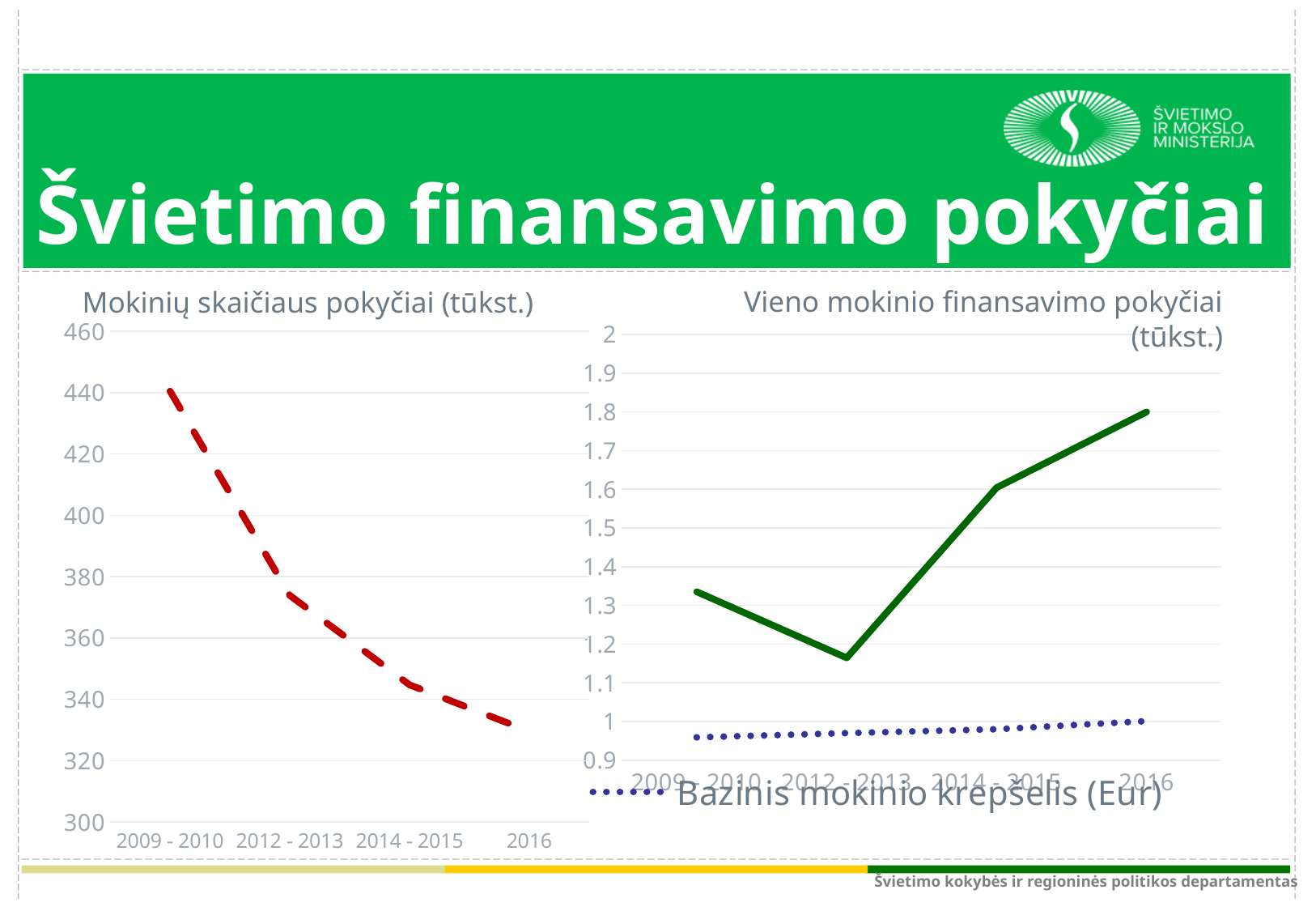
In the right chart 'Vieno mokinio finansavimo pokyčiai (tūkst.)', is the solid green line's value for 2014 - 2015 greater or less than 1.5? greater In the left chart 'Mokinių skaičiaus pokyčiai (tūkst.)', which period has the highest value? 2009 - 2010 In the left chart 'Mokinių skaičiaus pokyčiai (tūkst.)', which period has the lowest value? 2016 In the right chart 'Vieno mokinio finansavimo pokyčiai (tūkst.)', what legend label is shown for the dotted blue line? Bazinis mokinio krepšelis (Eur) In the right chart 'Vieno mokinio finansavimo pokyčiai (tūkst.)', is the solid green line's value higher in 2009 - 2010 or in 2012 - 2013? 2009 - 2010 In the left chart 'Mokinių skaičiaus pokyčiai (tūkst.)', how many periods are shown on the x axis? 4 What kind of chart is the right chart, 'Vieno mokinio finansavimo pokyčiai (tūkst.)'? line chart In the left chart 'Mokinių skaičiaus pokyčiai (tūkst.)', do the values rise or fall from 2009 - 2010 to 2016? fall In the right chart 'Vieno mokinio finansavimo pokyčiai (tūkst.)', in which period does the solid green line reach its lowest value? 2012 - 2013 What kind of chart is the left chart, 'Mokinių skaičiaus pokyčiai (tūkst.)'? line chart In the right chart 'Vieno mokinio finansavimo pokyčiai (tūkst.)', in which period does the solid green line reach its highest value? 2016 In the left chart 'Mokinių skaičiaus pokyčiai (tūkst.)', is the value for 2012 - 2013 greater or less than 380? less